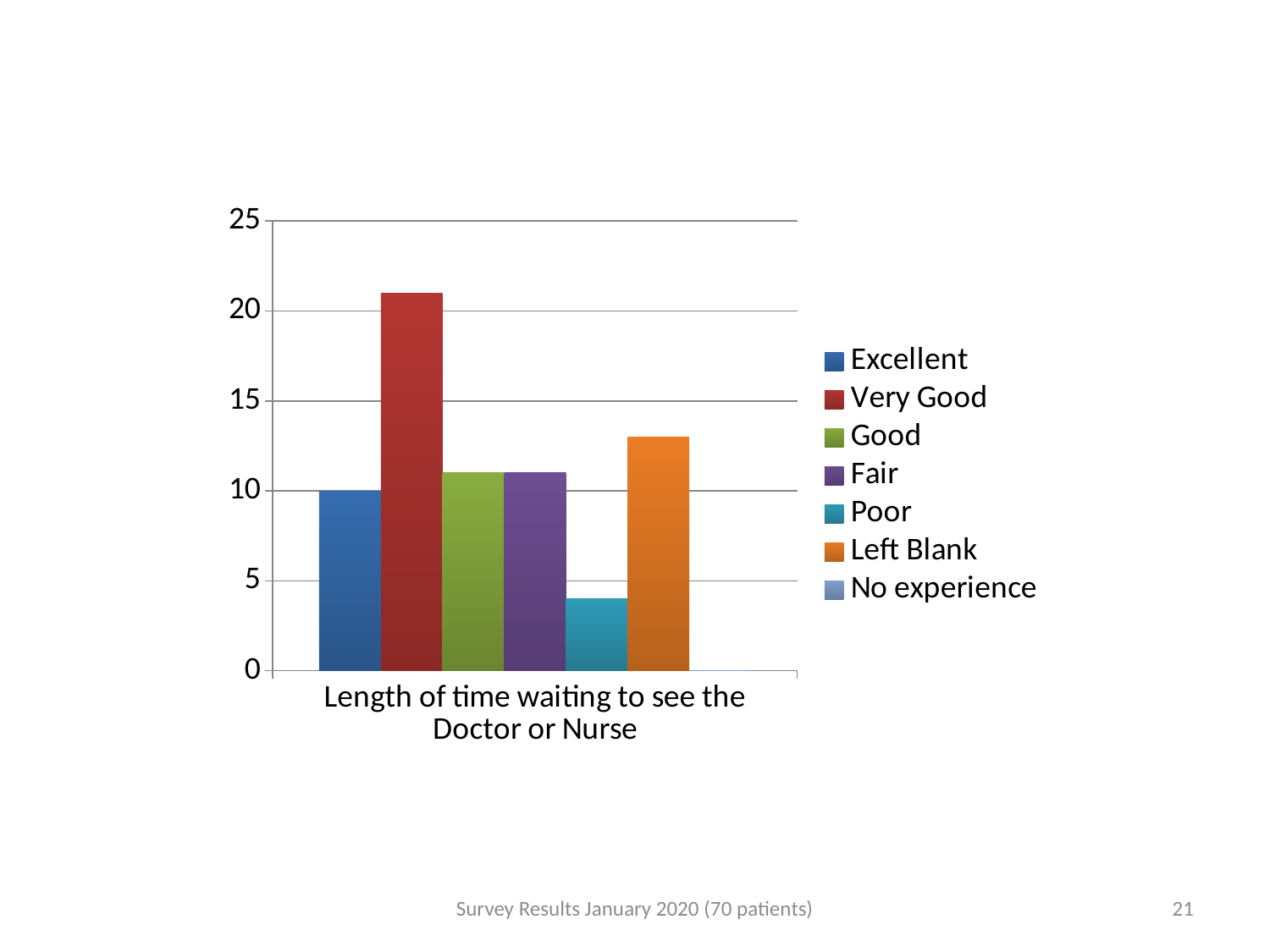
Is the value for Left Blank greater or less than 15? less What is the value for No experience? 0 How many series does the legend list? 7 Which series has the highest value? Very Good Which series has the lowest value? No experience Which is larger, the value for Very Good or the value for Left Blank? Very Good Is the value for Very Good greater or less than 20? greater What is the value for Excellent? 10 Which is larger, the value for Excellent or the value for Poor? Excellent Is the value for Poor greater or less than 5? less What kind of chart is shown on the slide? bar chart What is the category label shown on the x axis? Length of time waiting to see the Doctor or Nurse